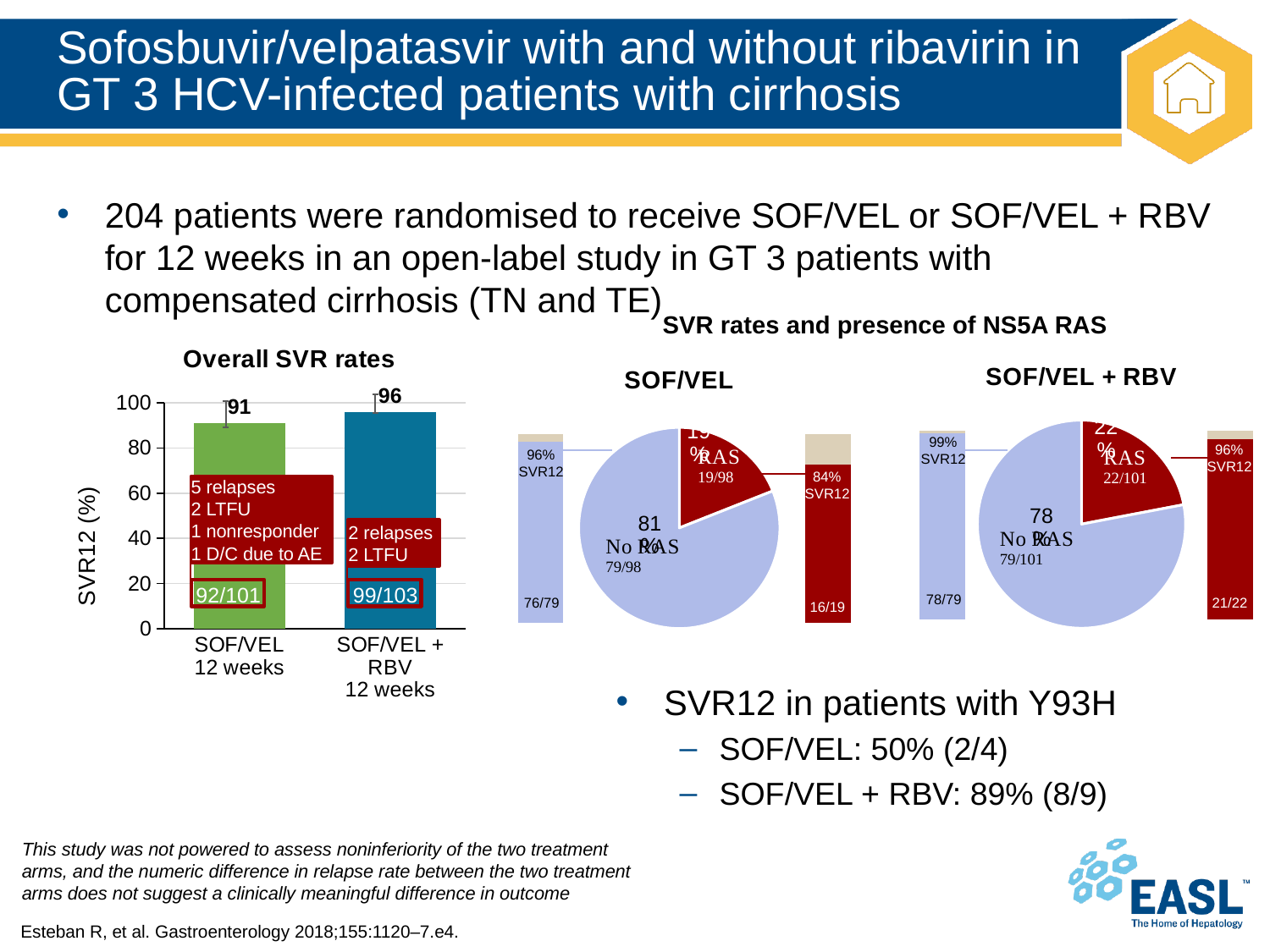
In the Overall SVR rates chart, which treatment arm has the higher SVR12 rate? SOF/VEL + RBV 12 weeks What kind of chart is the Overall SVR rates chart? Bar chart In the Overall SVR rates chart, what is the SVR12 value for SOF/VEL 12 weeks? 91 In the SVR rates and presence of NS5A RAS section, what is the SVR12 rate for SOF/VEL + RBV patients with no RAS? 99% In the Overall SVR rates chart, what is the difference in SVR12 between SOF/VEL + RBV 12 weeks and SOF/VEL 12 weeks? 5 In the SOF/VEL pie chart under SVR rates and presence of NS5A RAS, what percentage of patients had no RAS? 81% In the Overall SVR rates chart, what is the patient fraction shown for the SOF/VEL + RBV 12 weeks bar? 99/103 In the SOF/VEL + RBV pie chart under SVR rates and presence of NS5A RAS, what percentage of patients had RAS? 22% In the Overall SVR rates chart, is the value for SOF/VEL 12 weeks greater or less than 80? greater In the Overall SVR rates chart, what is the SVR12 value for SOF/VEL + RBV 12 weeks? 96 In the SVR rates and presence of NS5A RAS section, what is the SVR12 rate for SOF/VEL patients with RAS? 84% In the Overall SVR rates chart, how many treatment arms are plotted? 2